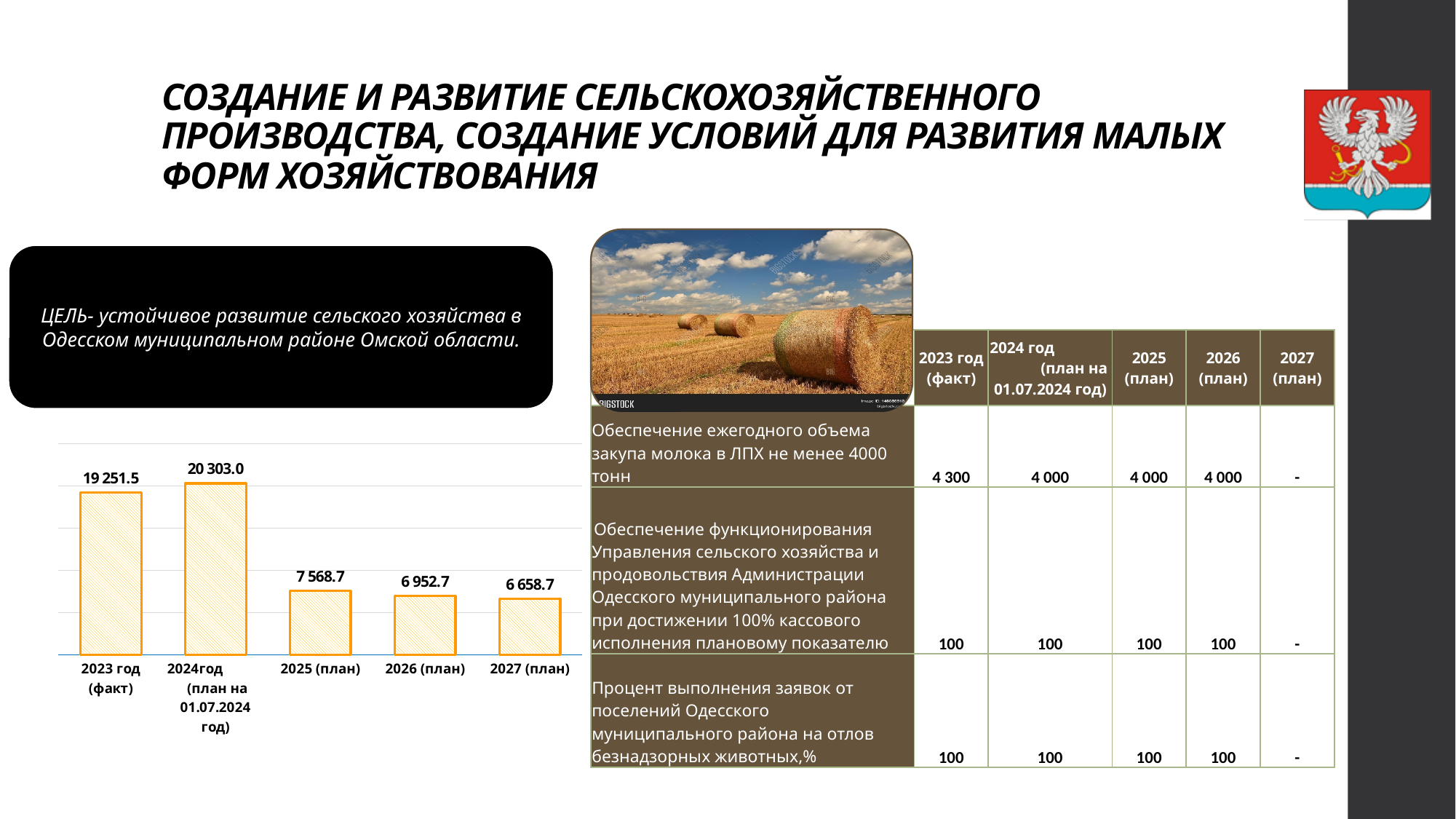
What is the value for 2023 год (факт) in the bar chart? 19 251.5 What is the value for 2024год (план на 01.07.2024 год) in the bar chart? 20 303.0 What is the difference between the values for 2025 (план) and 2026 (план) in the bar chart? 616.0 How many bars are shown in the bar chart? 5 Which category has the lowest value in the bar chart? 2027 (план) What is the value for 2025 (план) in the bar chart? 7 568.7 What type of chart is shown on the slide? Bar chart What is the value for 2026 (план) in the bar chart? 6 952.7 What is the difference between the values for 2024год (план на 01.07.2024 год) and 2023 год (факт) in the bar chart? 1 051.5 What is the value for 2027 (план) in the bar chart? 6 658.7 Which category has the highest value in the bar chart? 2024год (план на 01.07.2024 год) Which is larger in the bar chart: the value for 2023 год (факт) or the value for 2025 (план)? 2023 год (факт)